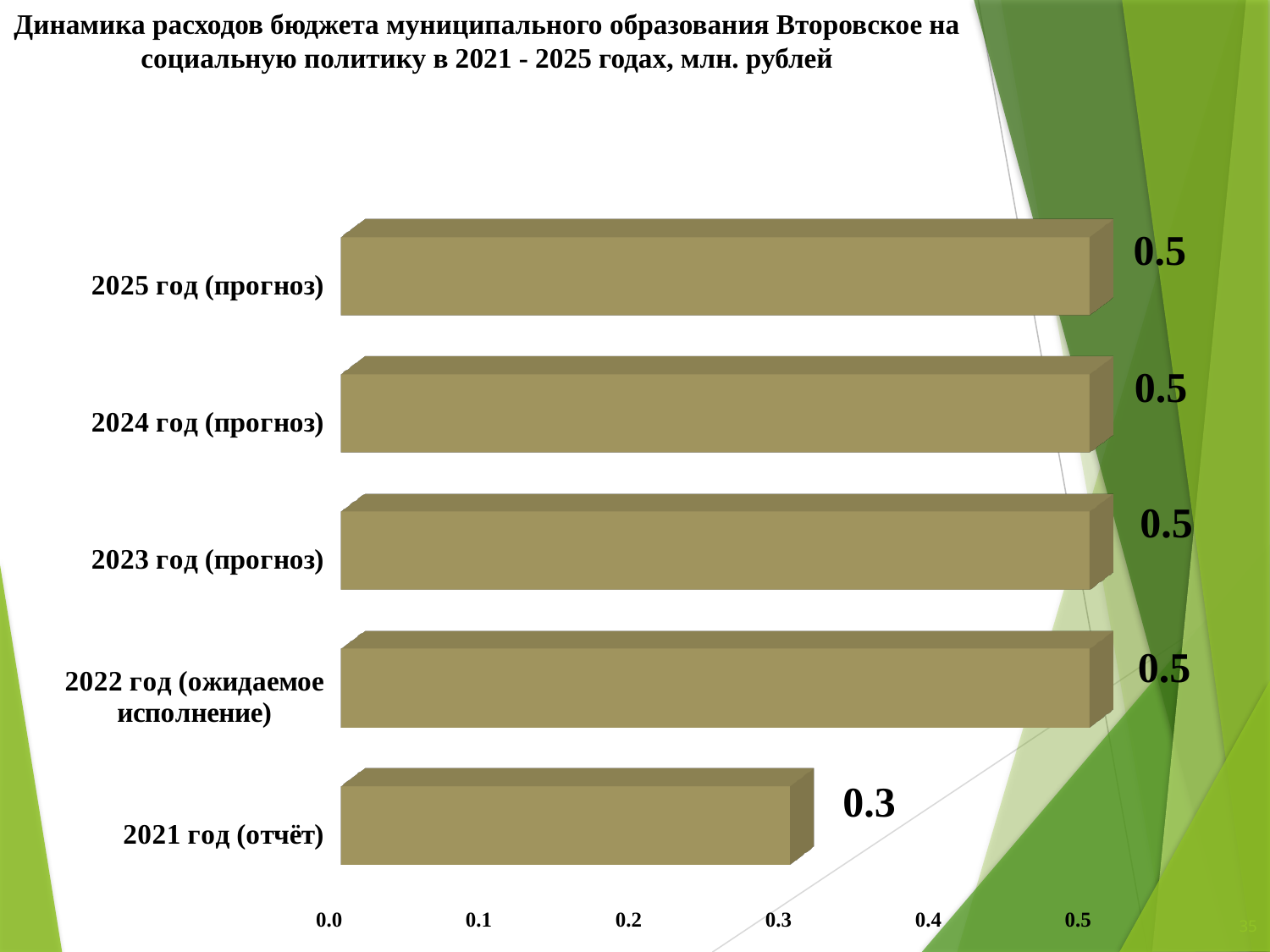
What is the value for 2021 год (отчёт)? 0.3 What is the value for 2023 год (прогноз)? 0.5 Which is larger, the value for 2024 год (прогноз) or the value for 2021 год (отчёт)? 2024 год (прогноз) In what units are the values in the chart expressed, according to the title? млн. рублей What is the difference between the values for 2022 год (ожидаемое исполнение) and 2021 год (отчёт)? 0.2 Do the values rise or fall from 2021 год (отчёт) to 2022 год (ожидаемое исполнение)? rise Is the value for 2021 год (отчёт) greater or less than 0.4? less What is the value for 2022 год (ожидаемое исполнение)? 0.5 Which category has the lowest value? 2021 год (отчёт) What kind of chart is shown on the slide? bar chart How many categories are shown in the chart? 5 What is the value for 2025 год (прогноз)? 0.5